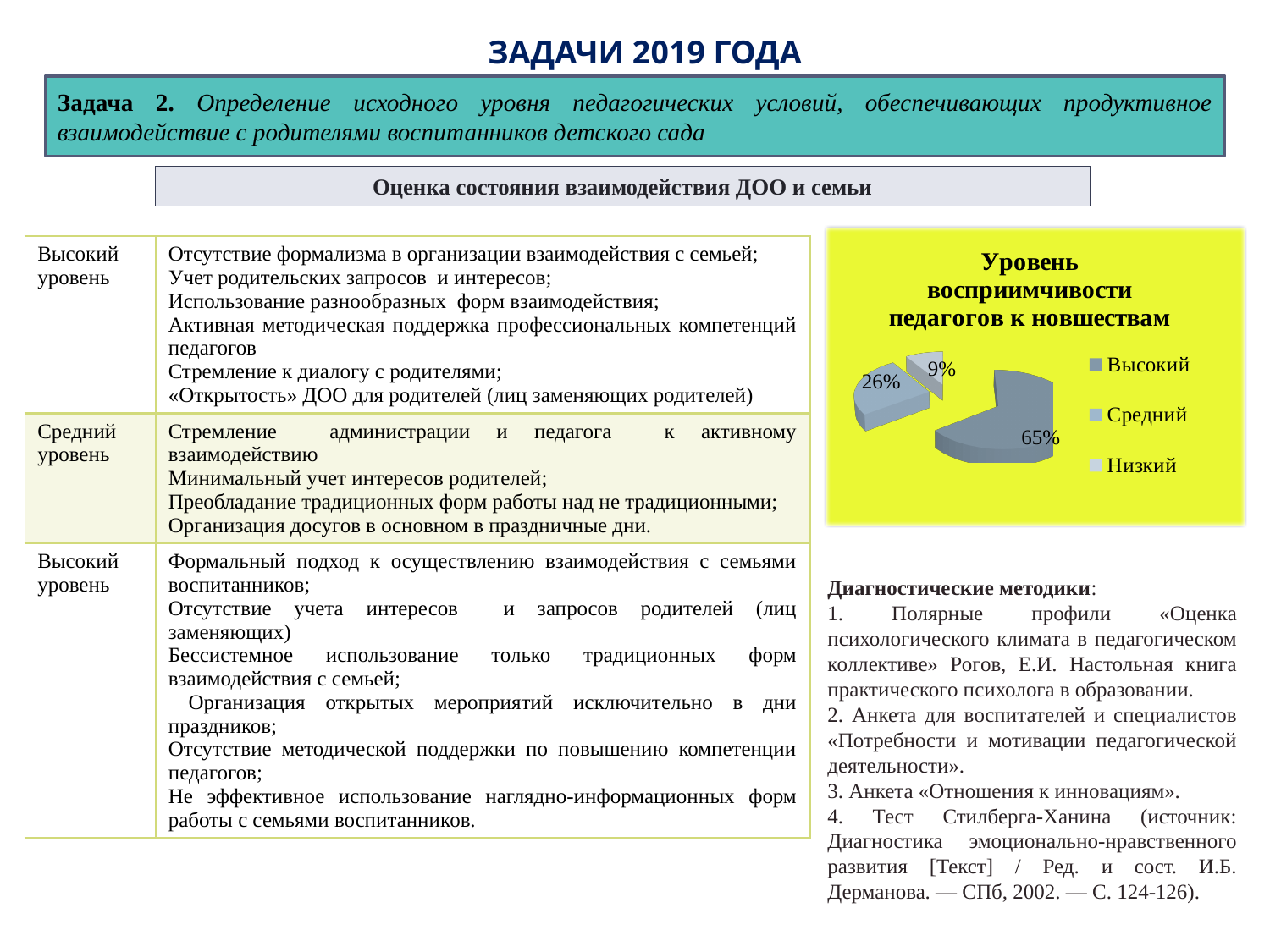
What do the three labelled shares in the pie chart add up to? 100% How many entries does the legend of the pie chart list? 3 What is the title of the pie chart? Уровень восприимчивости педагогов к новшествам What share of the pie chart is labelled for the Средний level? 26% How many slices does the pie chart have? 3 Which level has the smallest slice in the pie chart? Низкий What is the difference between the Высокий and Средний shares in the pie chart? 39% Which is larger in the pie chart, the Средний share or the Низкий share? Средний Which level has the largest slice in the pie chart? Высокий What share of the pie chart is labelled for the Высокий level? 65% What kind of chart is shown on the slide? pie chart What share of the pie chart is labelled for the Низкий level? 9%